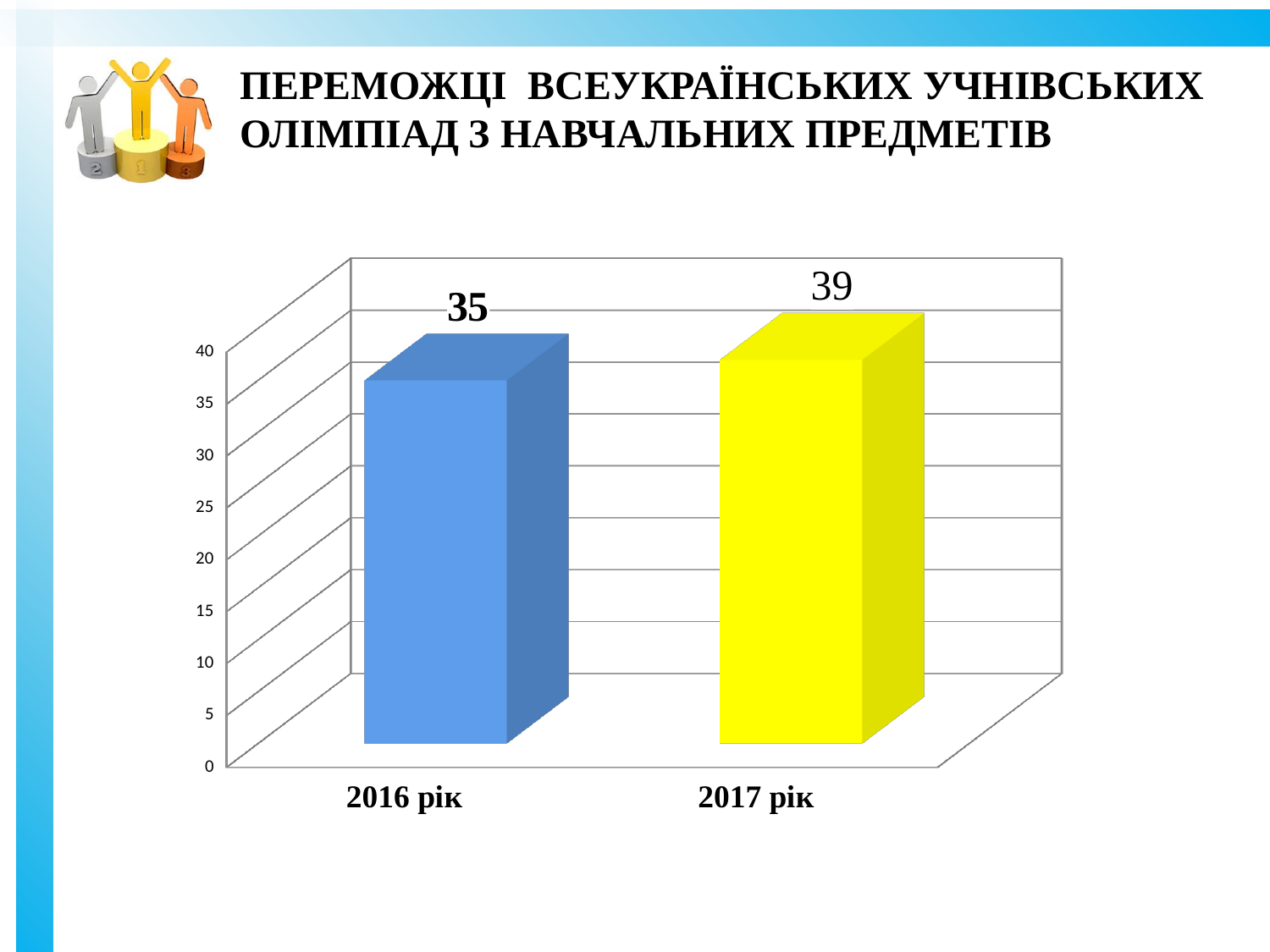
Is the value for 2017 рік greater or less than 40? less What kind of chart is shown on the slide? bar chart Which year has the lowest value? 2016 рік Which is larger, the value for 2016 рік or the value for 2017 рік? 2017 рік Which year has the highest value? 2017 рік How many categories are shown on the x axis? 2 What colour is the bar for 2017 рік? yellow Is the value for 2016 рік greater or less than 30? greater What is the value for 2017 рік? 39 What is the value for 2016 рік? 35 Do the values rise or fall from 2016 рік to 2017 рік? rise What is the difference between the values for 2017 рік and 2016 рік? 4